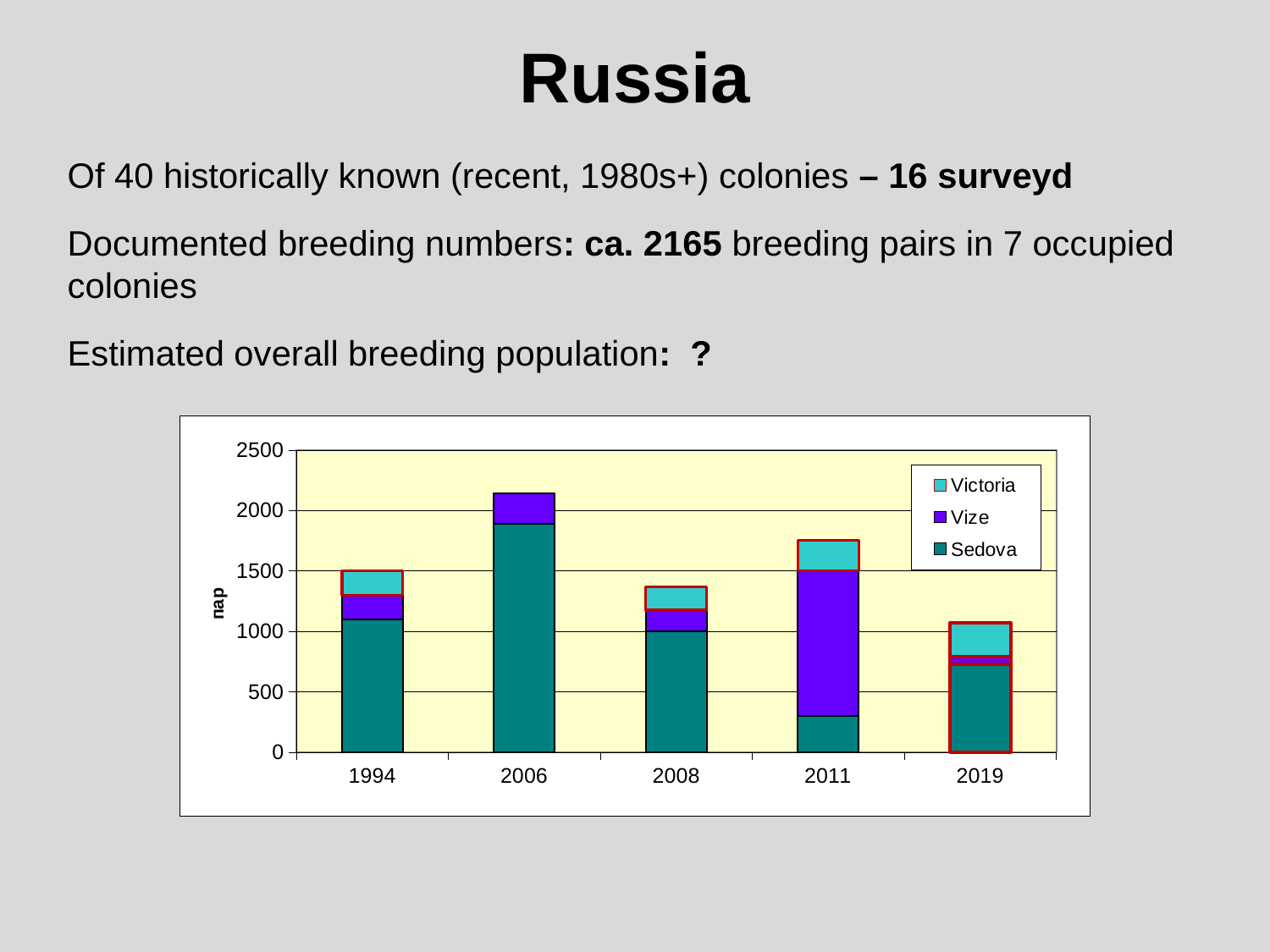
What kind of chart is shown on the slide? stacked bar chart How many years are shown on the x axis of the chart? 5 Which is larger, the Sedova segment for 2006 or the Sedova segment for 2011? 2006 What is the label on the chart's vertical axis? пар How many series does the chart's legend list? 3 Which series are listed in the chart's legend? Victoria, Vize, Sedova Is the total stacked value for 2006 greater or less than 2000? greater Is the Sedova value for 2011 greater or less than 500? less Which year has the shortest stacked bar in the chart? 2019 In which year is the Vize segment the largest? 2011 Is the total stacked value for 2008 greater or less than 1500? less Which year has the tallest stacked bar in the chart? 2006